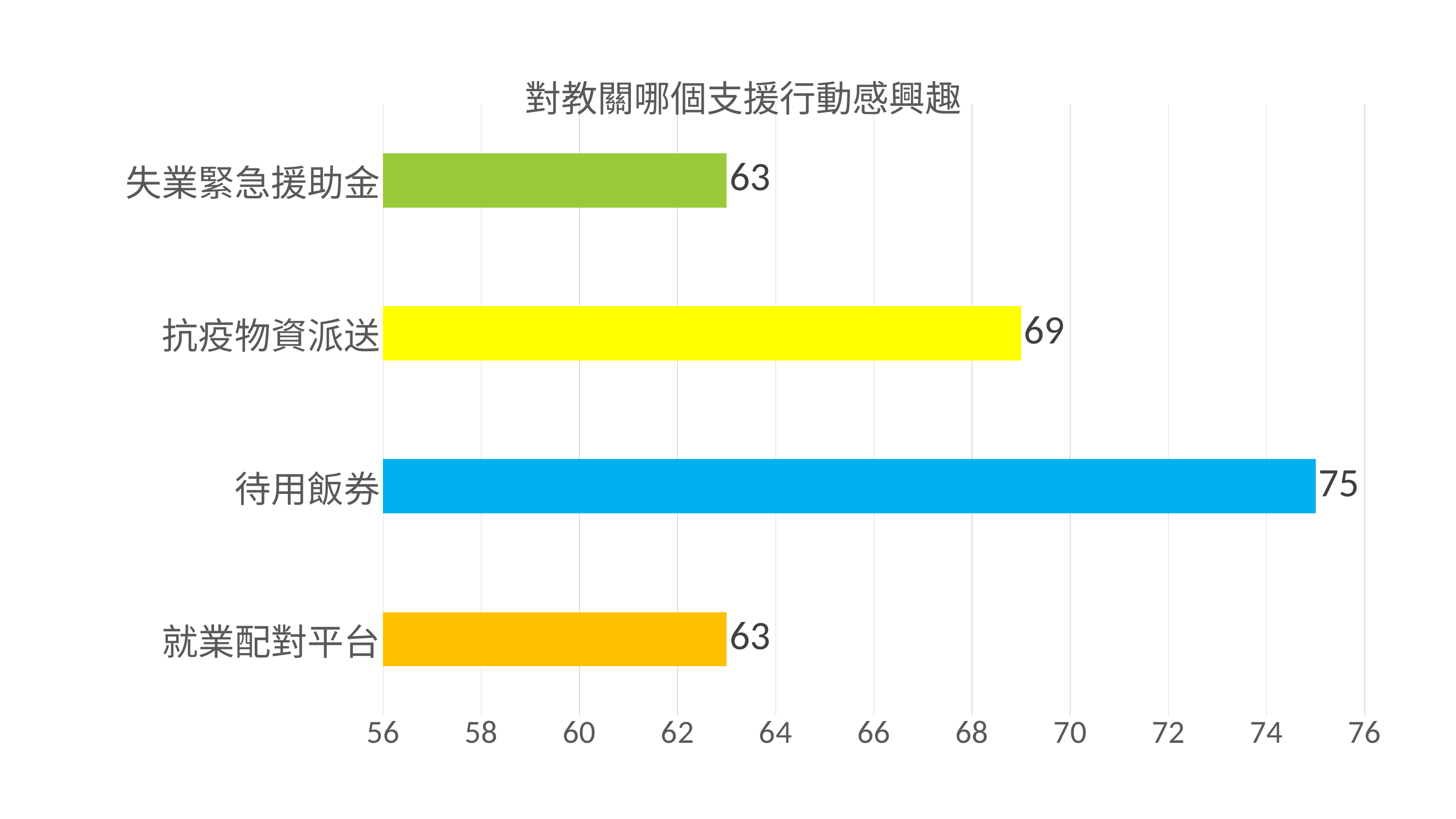
What is the value for 待用飯券? 75 Which is larger, the value for 抗疫物資派送 or the value for 失業緊急援助金? 抗疫物資派送 What is the difference between the values for 待用飯券 and 抗疫物資派送? 6 What is the difference between the values for 抗疫物資派送 and 就業配對平台? 6 What is the title of the chart? 對教關哪個支援行動感興趣 What is the value for 失業緊急援助金? 63 Is the value for 待用飯券 greater or less than 70? greater Which category has the highest value? 待用飯券 What is the value for 抗疫物資派送? 69 How many categories are shown in the chart? 4 What is the value for 就業配對平台? 63 What kind of chart is shown on the slide? bar chart